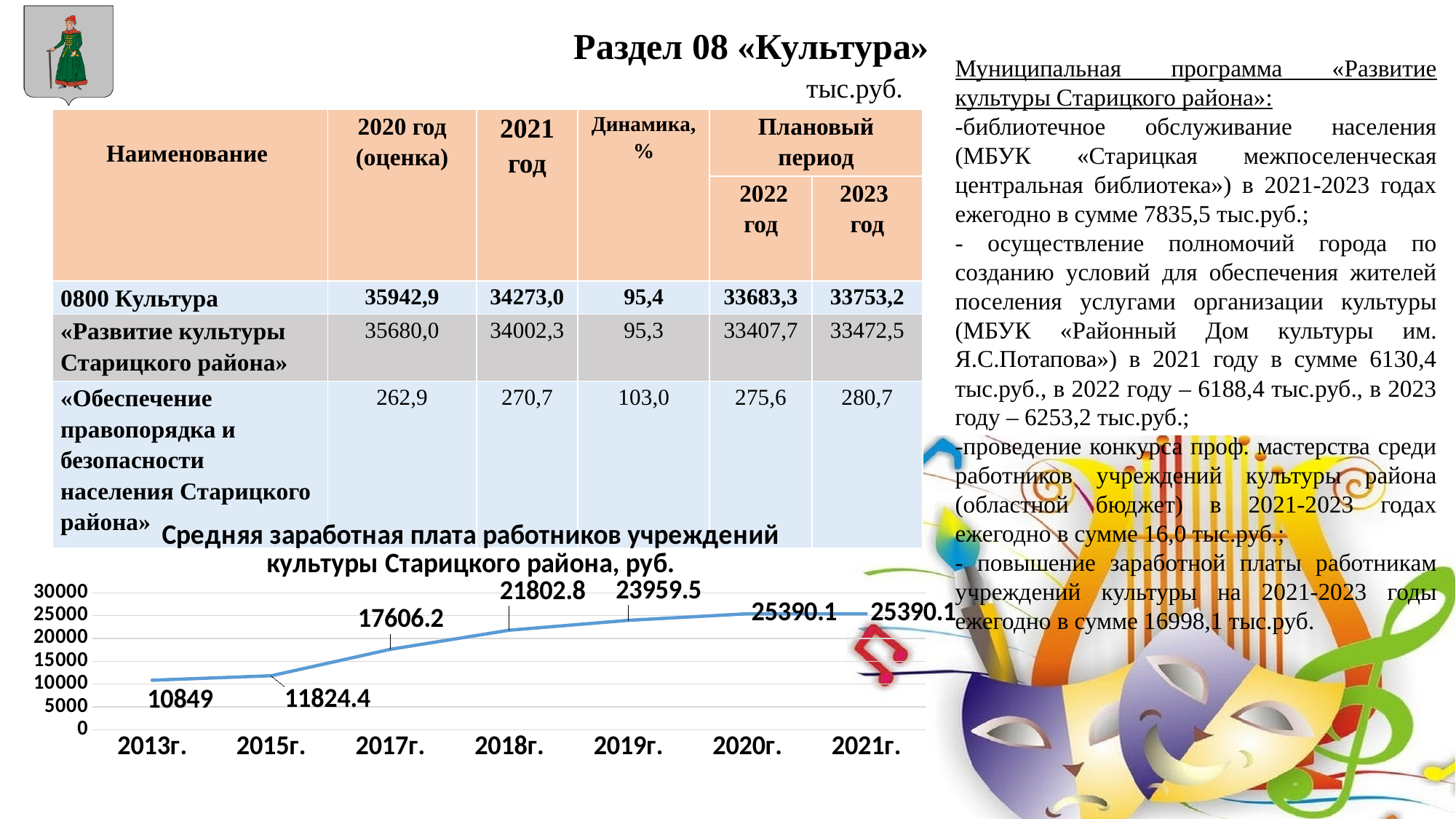
How many data points are plotted in the chart? 7 What is the value for 2013г. in the chart? 10849 Which is larger, the value for 2019г. or the value for 2018г.? 2019г. What kind of chart is shown on the slide? line chart What is the value for 2017г. in the chart? 17606.2 What is the value for 2015г. in the chart? 11824.4 What is the value for 2019г. in the chart? 23959.5 What is the difference between the values for 2018г. and 2017г.? 4196.6 Do the values in the chart generally rise or fall from 2013г. to 2021г.? rise What is the value for 2021г. in the chart? 25390.1 Which year has the lowest value in the chart? 2013г. What is the title of the chart? Средняя заработная плата работников учреждений культуры Старицкого района, руб.